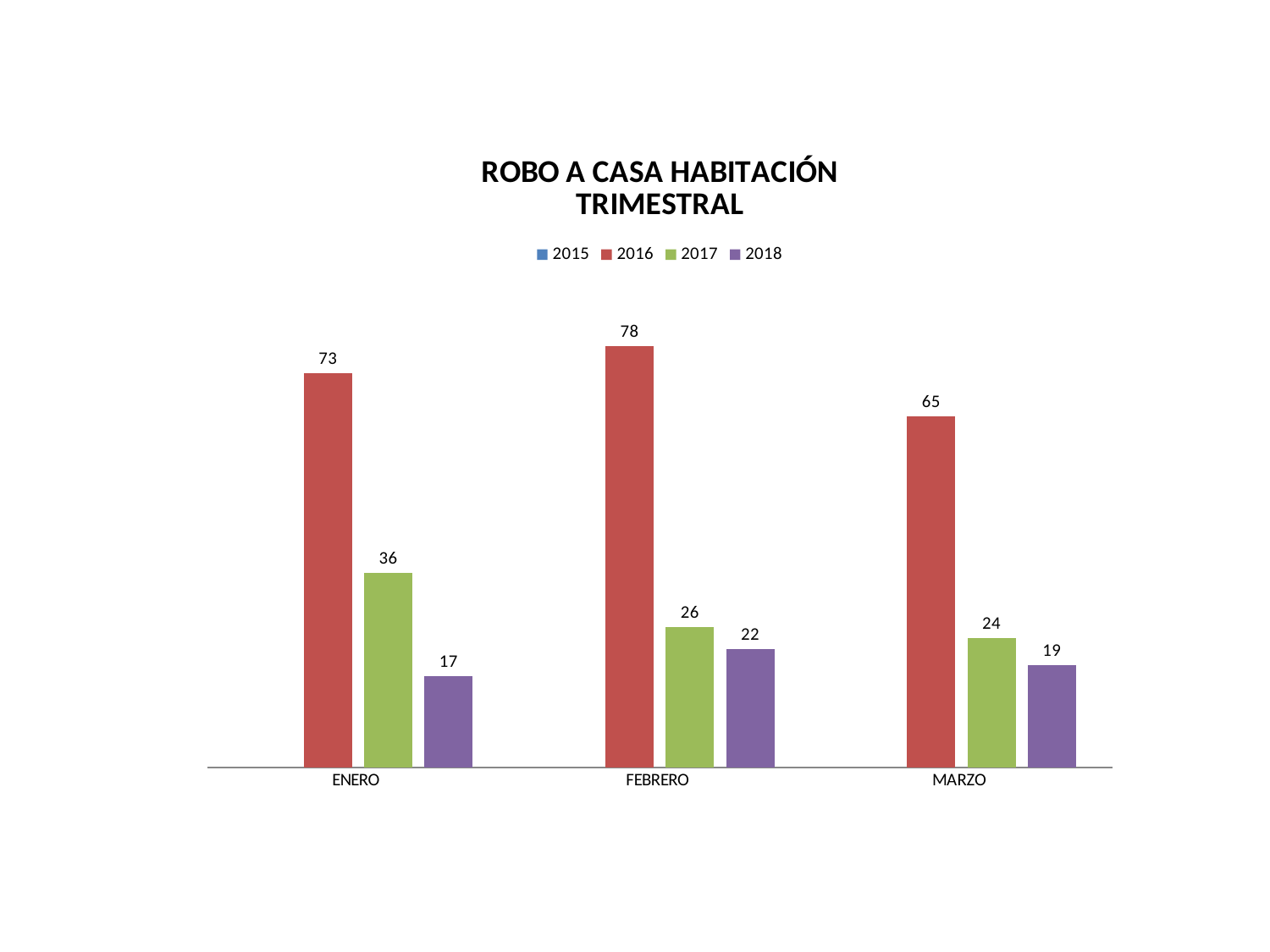
In which month is the 2016 value highest? FEBRERO What is the value for 2016 in ENERO? 73 In which month is the 2018 value lowest? ENERO Which is larger, the 2017 value in ENERO or the 2017 value in MARZO? ENERO What kind of chart is this? bar chart What is the value for 2017 in FEBRERO? 26 What is the title of the chart? ROBO A CASA HABITACIÓN TRIMESTRAL How many series does the legend list? 4 What is the difference between the 2016 and 2017 values in ENERO? 37 What is the difference between the 2016 values for FEBRERO and MARZO? 13 What is the value for 2018 in MARZO? 19 How many months are shown on the x axis? 3